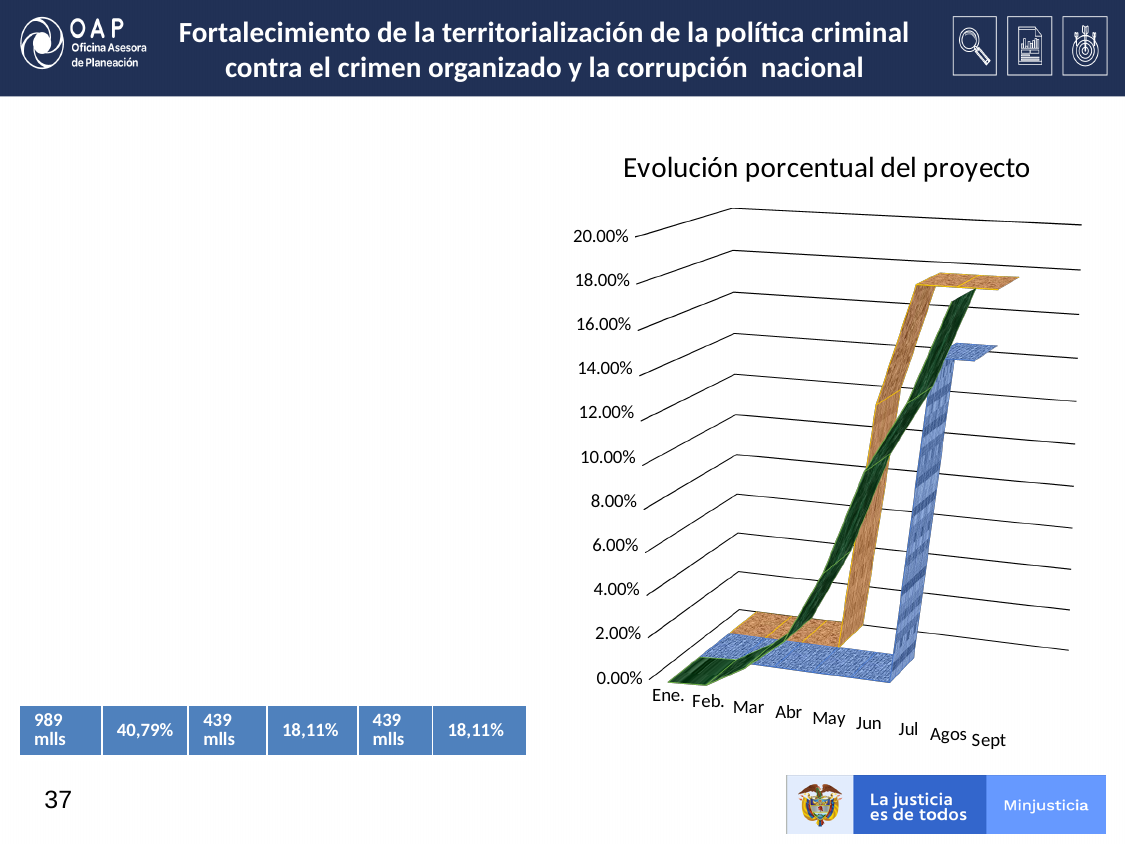
Do the values in the chart rise or fall from Ene. to Sept? rise What is the highest value shown on the chart's vertical axis? 20.00% What kind of chart is shown on the slide? 3D line chart What is the title of the chart on the slide? Evolución porcentual del proyecto Which is the last month label on the x axis of the chart? Sept Is the value for Ene. greater or less than 2.00%? less How many months are shown on the x axis of the chart? 9 Is the value for Mar in the blue series greater or less than 4.00%? less Which is the first month label on the x axis of the chart? Ene.